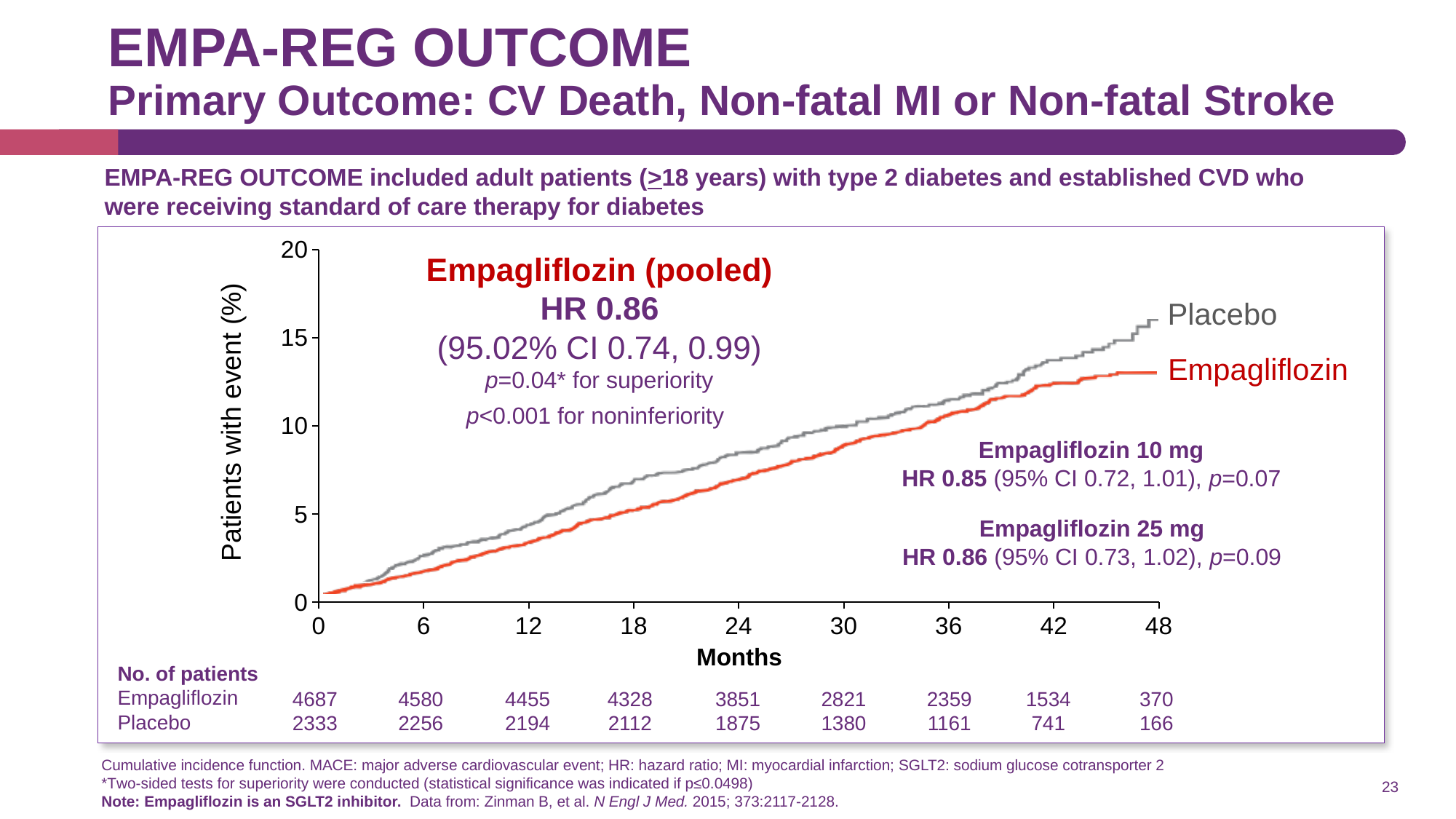
What kind of chart is shown on the slide? Line chart What is the p-value for superiority shown for Empagliflozin (pooled)? p=0.04* Is the Empagliflozin curve at 48 months greater or less than 15%? less What is the label of the y-axis? Patients with event (%) What is the hazard ratio for Empagliflozin (pooled) shown on the chart? HR 0.86 What is the number of Placebo patients at 24 months in the No. of patients table? 1875 Is the Placebo curve at 48 months greater or less than 15%? greater Do the cumulative incidence curves rise or fall as months increase? Rise At 48 months, which curve is higher: Placebo or Empagliflozin? Placebo What is the number of Empagliflozin patients at 0 months in the No. of patients table? 4687 How many treatment groups (series) are plotted on the chart? 2 What is the difference between the number of Empagliflozin patients and Placebo patients at 48 months? 204